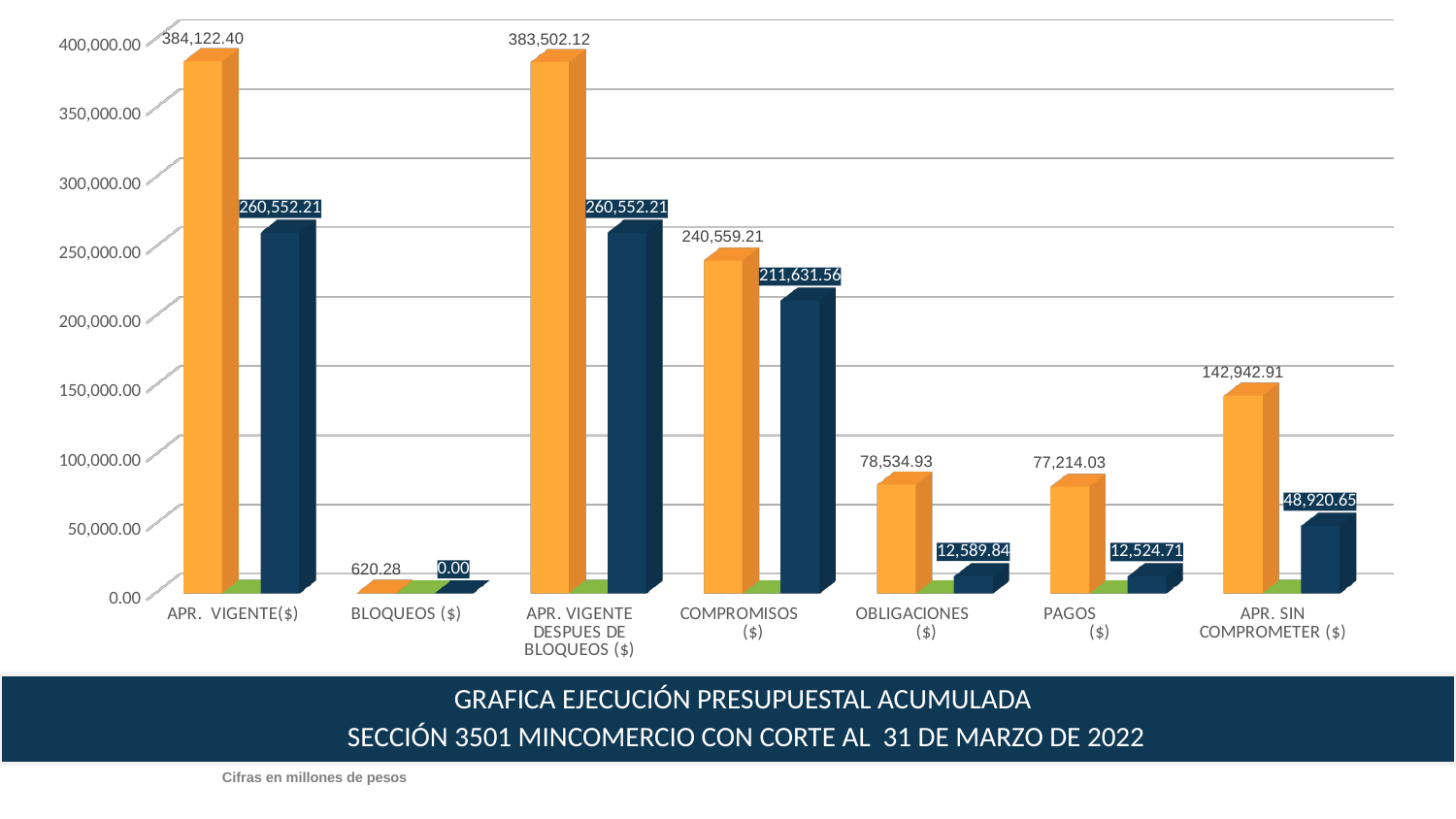
What is the value of the orange bar for BLOQUEOS ($)? 620.28 What is the value of the dark blue bar for OBLIGACIONES ($)? 12,589.84 Which category has the highest orange bar? APR. VIGENTE($) Which has the larger orange bar, OBLIGACIONES ($) or PAGOS ($)? OBLIGACIONES ($) What type of chart is shown on the slide? bar chart For COMPROMISOS ($), what is the difference between the orange bar and the dark blue bar? 28,927.65 What is the value of the orange bar for COMPROMISOS ($)? 240,559.21 What is the difference between the orange bar for APR. VIGENTE($) and the orange bar for APR. VIGENTE DESPUES DE BLOQUEOS ($)? 620.28 Which category has the lowest orange bar? BLOQUEOS ($) What is the value of the dark blue bar for APR. SIN COMPROMETER ($)? 48,920.65 Is the orange bar for APR. SIN COMPROMETER ($) greater or less than 100,000.00? greater How many categories are shown on the x axis? 7